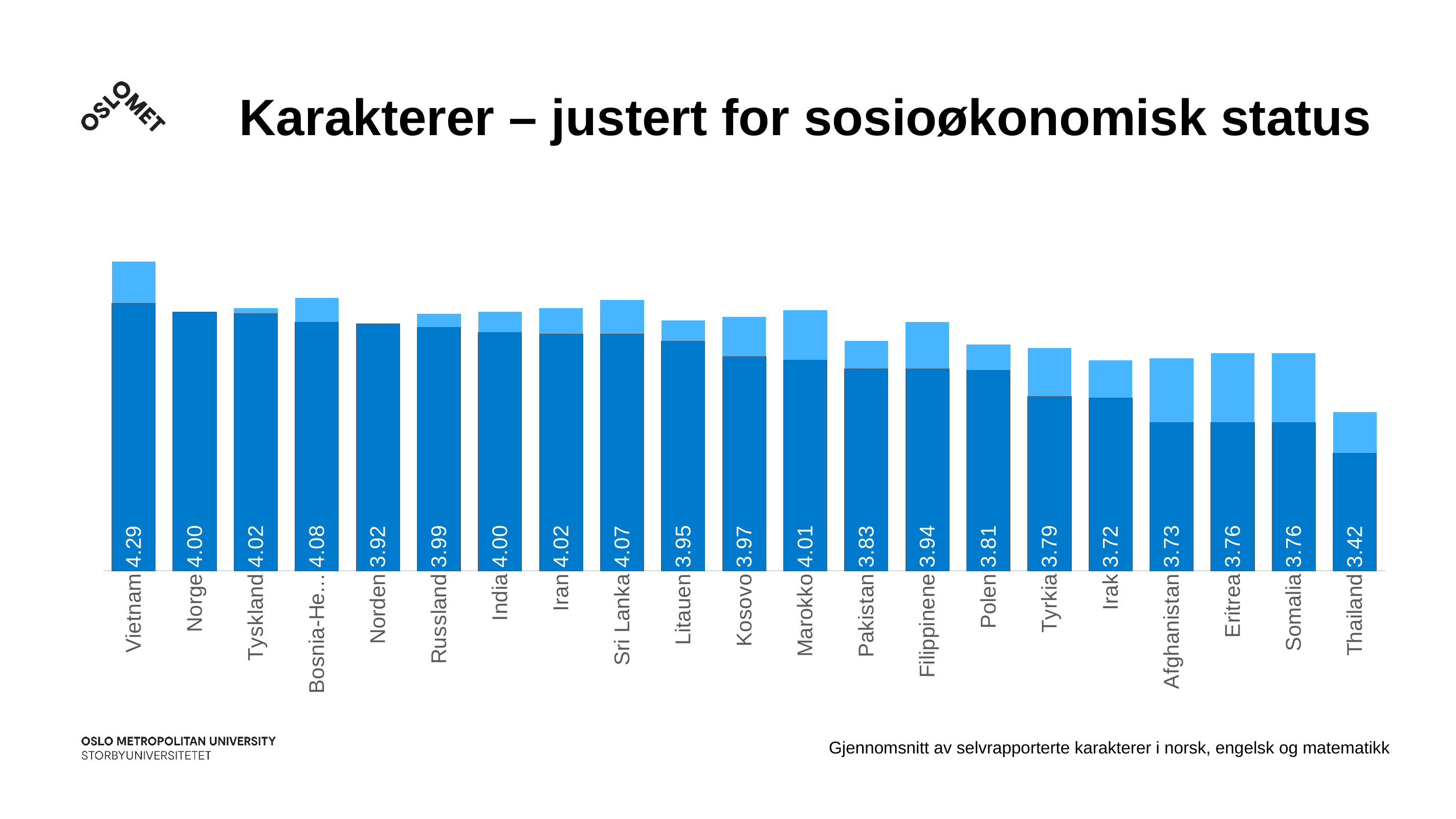
What value is labelled for Pakistan? 3.83 What is the difference between the labelled values for Vietnam and Thailand? 0.87 Which has the larger labelled value, Norge or Pakistan? Norge What value is labelled for Sri Lanka? 4.07 Which country has the highest labelled value? Vietnam Which country has the lowest labelled value? Thailand What value is labelled for Vietnam? 4.29 What kind of chart is shown on the slide? Bar chart How many countries or regions are shown on the x axis? 21 What is the title of the slide? Karakterer – justert for sosioøkonomisk status What value is labelled for Thailand? 3.42 Do the dark blue bars generally rise or fall from left to right? Fall